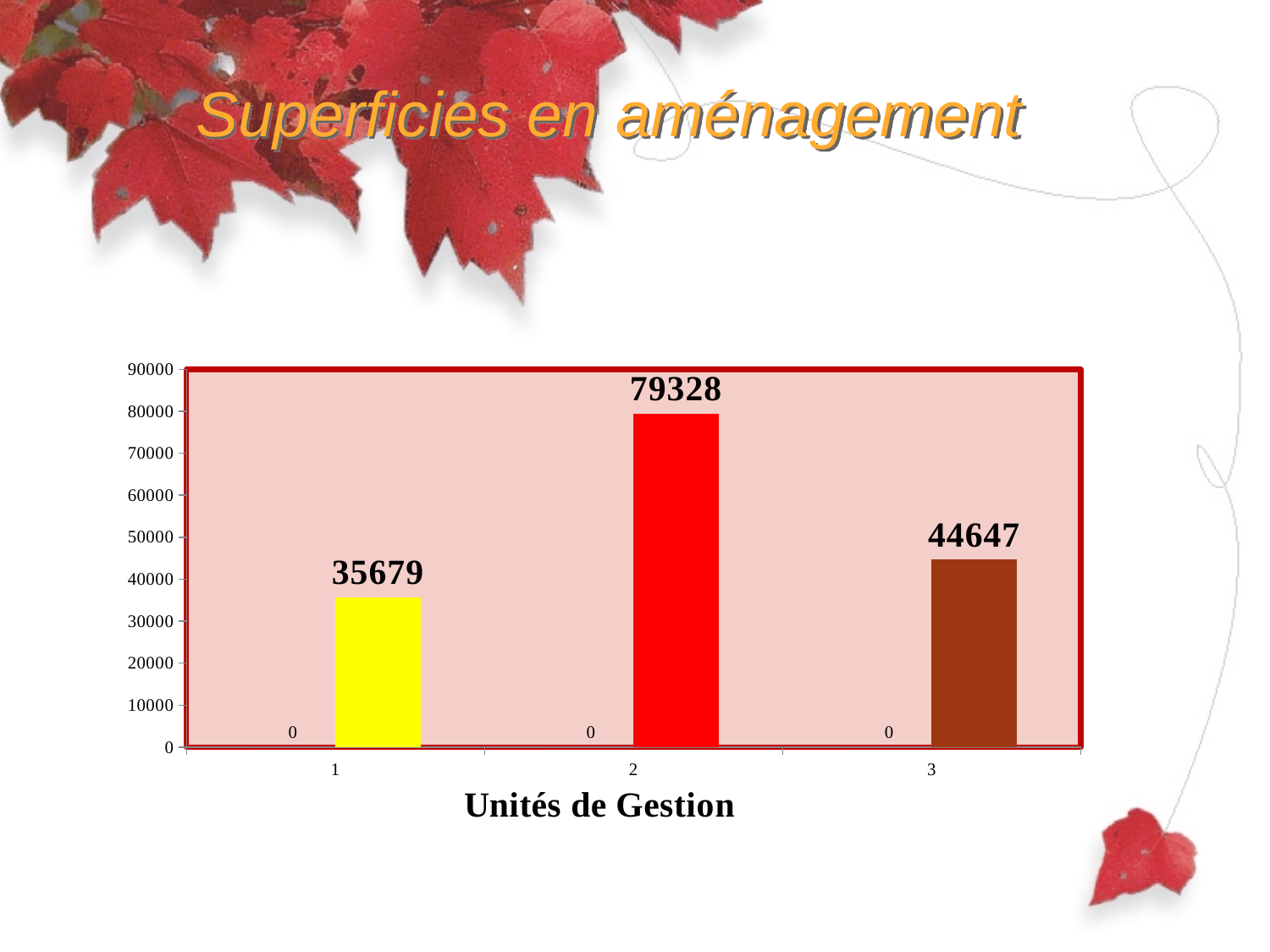
What is the value for Unité de Gestion 3? 44647 Is the value for Unité de Gestion 2 greater or less than 70000? greater Which Unité de Gestion has the highest value? 2 What is the value for Unité de Gestion 2? 79328 Which Unité de Gestion has the lowest non-zero value? 1 What is the value for Unité de Gestion 1? 35679 What is the difference between the values for Unité de Gestion 2 and Unité de Gestion 1? 43649 What is the label of the x axis? Unités de Gestion How many Unités de Gestion are shown on the x axis? 3 What is the difference between the values for Unité de Gestion 3 and Unité de Gestion 1? 8968 What kind of chart is shown on the slide? bar chart Which is larger, the value for Unité de Gestion 3 or Unité de Gestion 1? Unité de Gestion 3